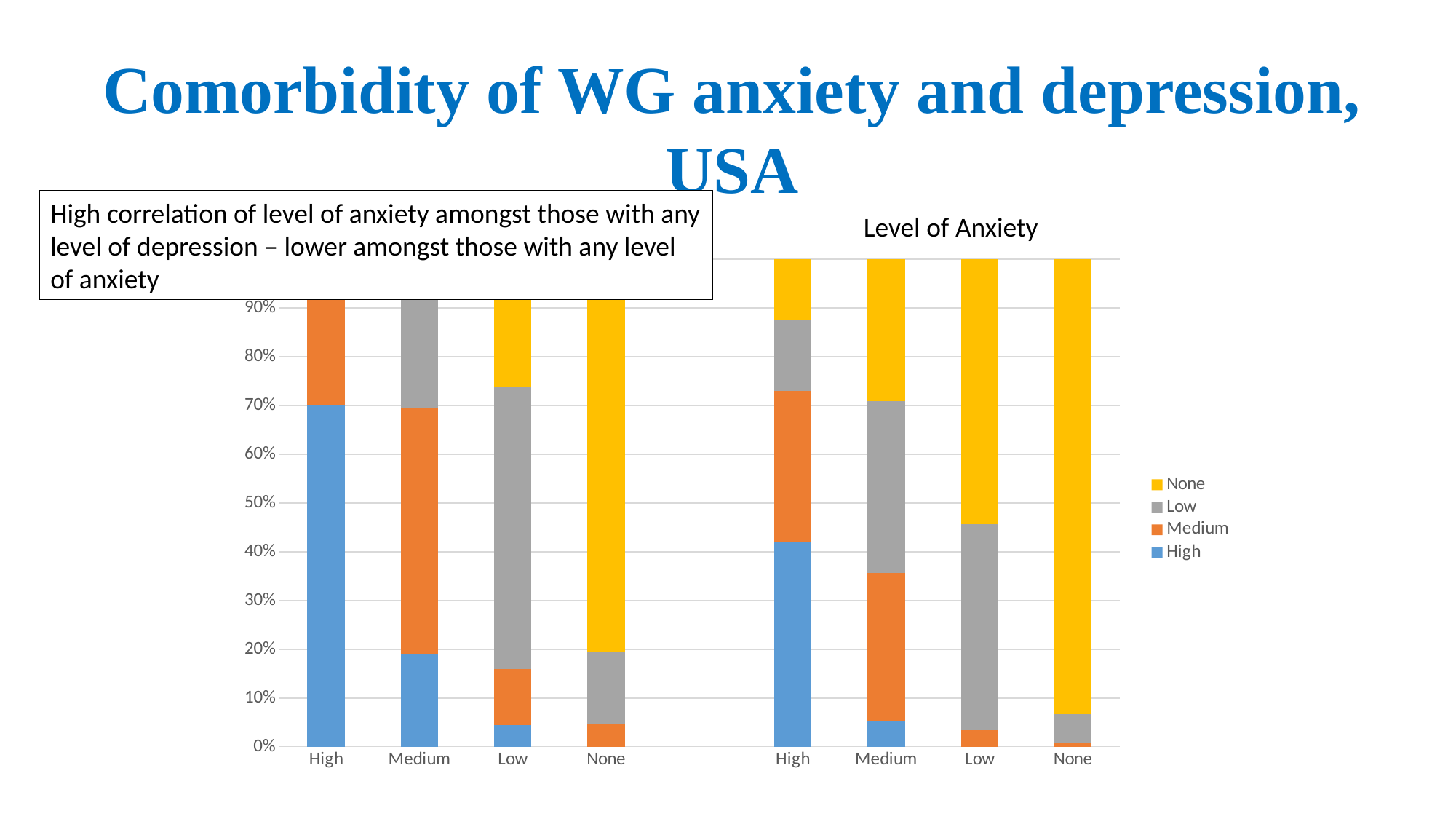
In the right-hand 'Level of Anxiety' group, is the High (blue) segment of the High bar greater or less than 30%? greater In the right-hand 'Level of Anxiety' group, is the Low (grey) segment of the Low bar greater or less than 30%? greater In the right-hand 'Level of Anxiety' group, which bar has the larger High (blue) segment, High or Medium? High In the left-hand group of bars, is the High (blue) segment of the Medium bar greater or less than 10%? greater In the right-hand 'Level of Anxiety' group, which category has the largest None (yellow) segment? None What kind of chart is shown on the slide? Stacked bar chart How many series does the chart legend list? 4 What are the entries in the chart legend? None, Low, Medium, High In the left-hand group of bars, which category has the largest High (blue) segment? High How many categories are shown on the x axis in the right-hand 'Level of Anxiety' group of bars? 4 What is the title shown above the right-hand group of bars? Level of Anxiety